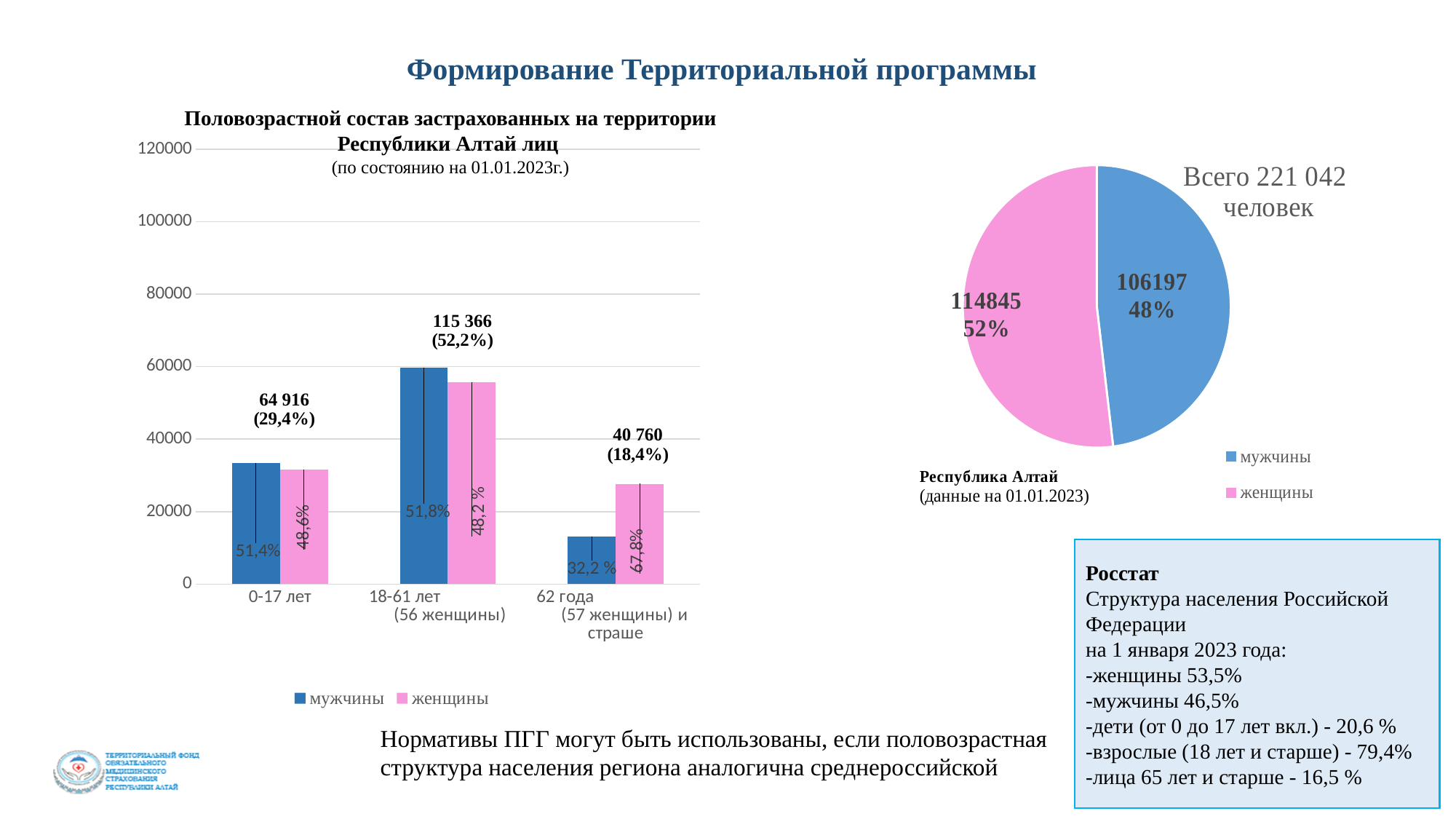
In the bar chart on the left, what percentage label is shown on the женщины bar for the group 62 года и старше? 67,8% In the bar chart on the left, which age group has the highest total number of insured persons? 18-61 лет In the pie chart on the right, what is the difference between the number of женщины and the number of мужчины? 8648 In the bar chart on the left, what total number is printed above the 18-61 лет group? 115 366 In the pie chart on the right, what is the value shown for мужчины? 106197 In the bar chart on the left, how many age groups are shown on the x axis? 3 In the pie chart on the right, what share of the total do женщины make up? 52% In the pie chart on the right, what total number of people is stated next to the chart? 221 042 In the pie chart on the right, which group is larger, мужчины or женщины? женщины What kind of chart is the chart on the left of the slide? bar chart In the bar chart on the left, is the value for мужчины in the 18-61 лет group greater or less than 40000? greater In the bar chart on the left, how many series does the legend list? 2